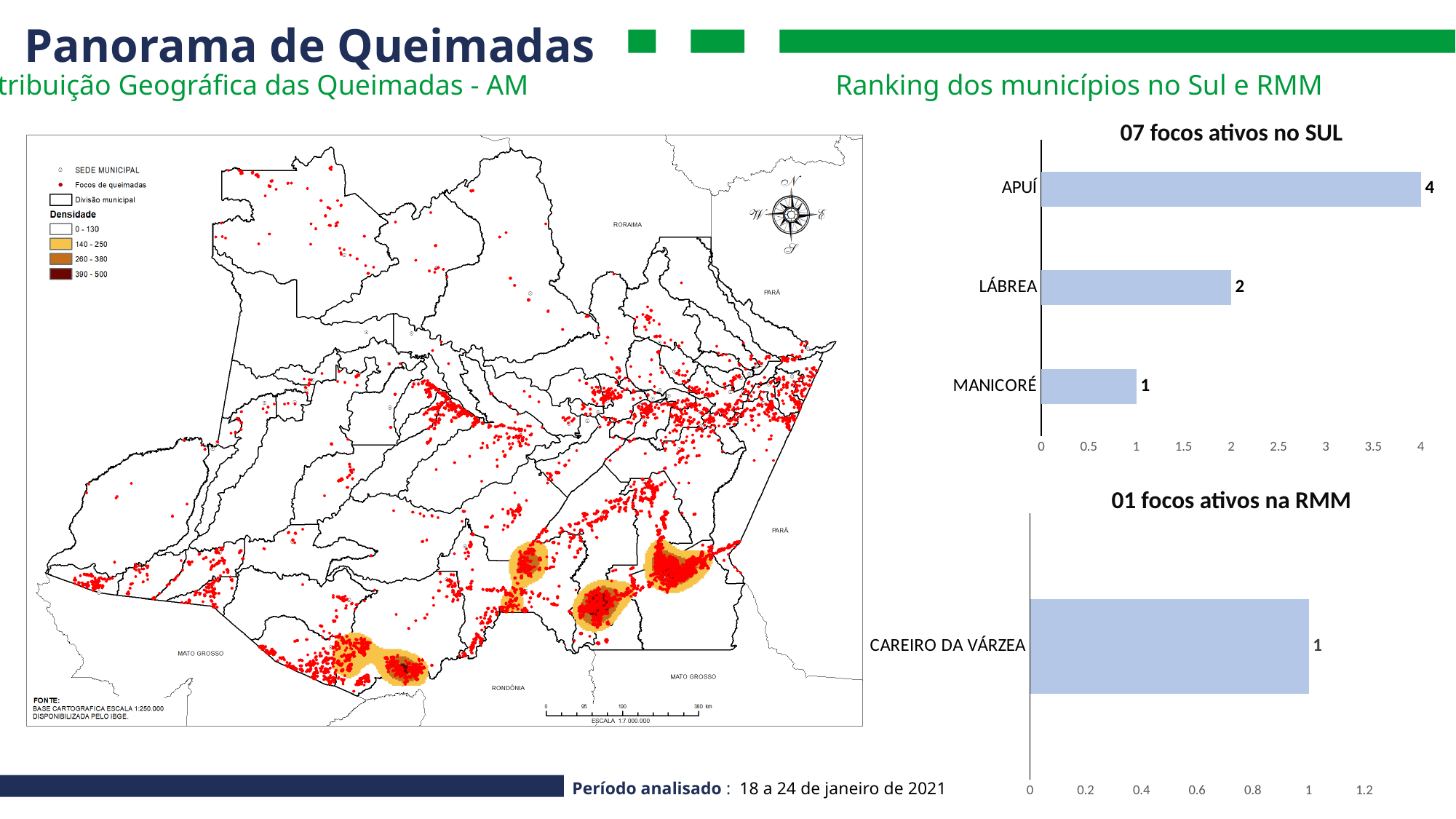
In the chart titled '07 focos ativos no SUL', what is the value for LÁBREA? 2 In the chart titled '07 focos ativos no SUL', which municipality has the lowest value? MANICORÉ In the chart titled '07 focos ativos no SUL', which municipality has the highest value? APUÍ What kind of chart is the one titled '07 focos ativos no SUL'? bar chart How many municipalities are shown in the chart titled '01 focos ativos na RMM'? 1 In the chart titled '07 focos ativos no SUL', which is larger, the value for LÁBREA or the value for MANICORÉ? LÁBREA In the chart titled '07 focos ativos no SUL', what is the difference between the values for APUÍ and LÁBREA? 2 In the chart titled '01 focos ativos na RMM', what is the value for CAREIRO DA VÁRZEA? 1 How many municipalities are shown in the chart titled '07 focos ativos no SUL'? 3 In the chart titled '07 focos ativos no SUL', what is the value for MANICORÉ? 1 What is the title of the lower chart on the right side of the slide? 01 focos ativos na RMM In the chart titled '07 focos ativos no SUL', what is the value for APUÍ? 4